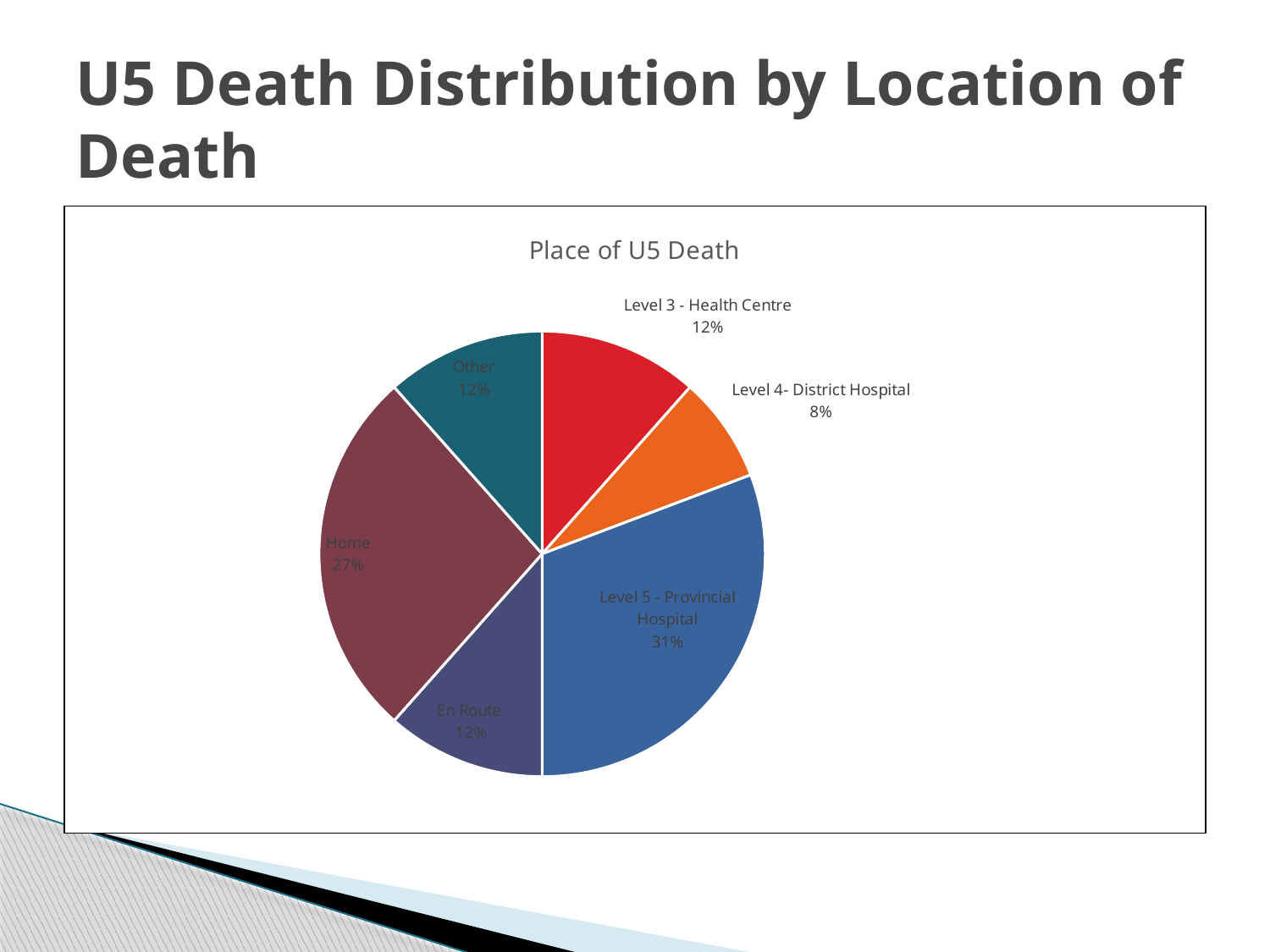
What is the title of the chart? Place of U5 Death What is the difference in percentage points between the Level 5 - Provincial Hospital share and the Home share? 4 percentage points What type of chart is shown on the slide? Pie chart What share of U5 deaths occurred at Level 3 - Health Centre? 12% What share of U5 deaths occurred at Level 4- District Hospital? 8% What share of U5 deaths occurred En Route? 12% Which location has the smallest share of U5 deaths? Level 4- District Hospital Which is larger, the share for Home or the share for Other? Home How many slices does the pie chart have? 6 Which location has the largest share of U5 deaths? Level 5 - Provincial Hospital